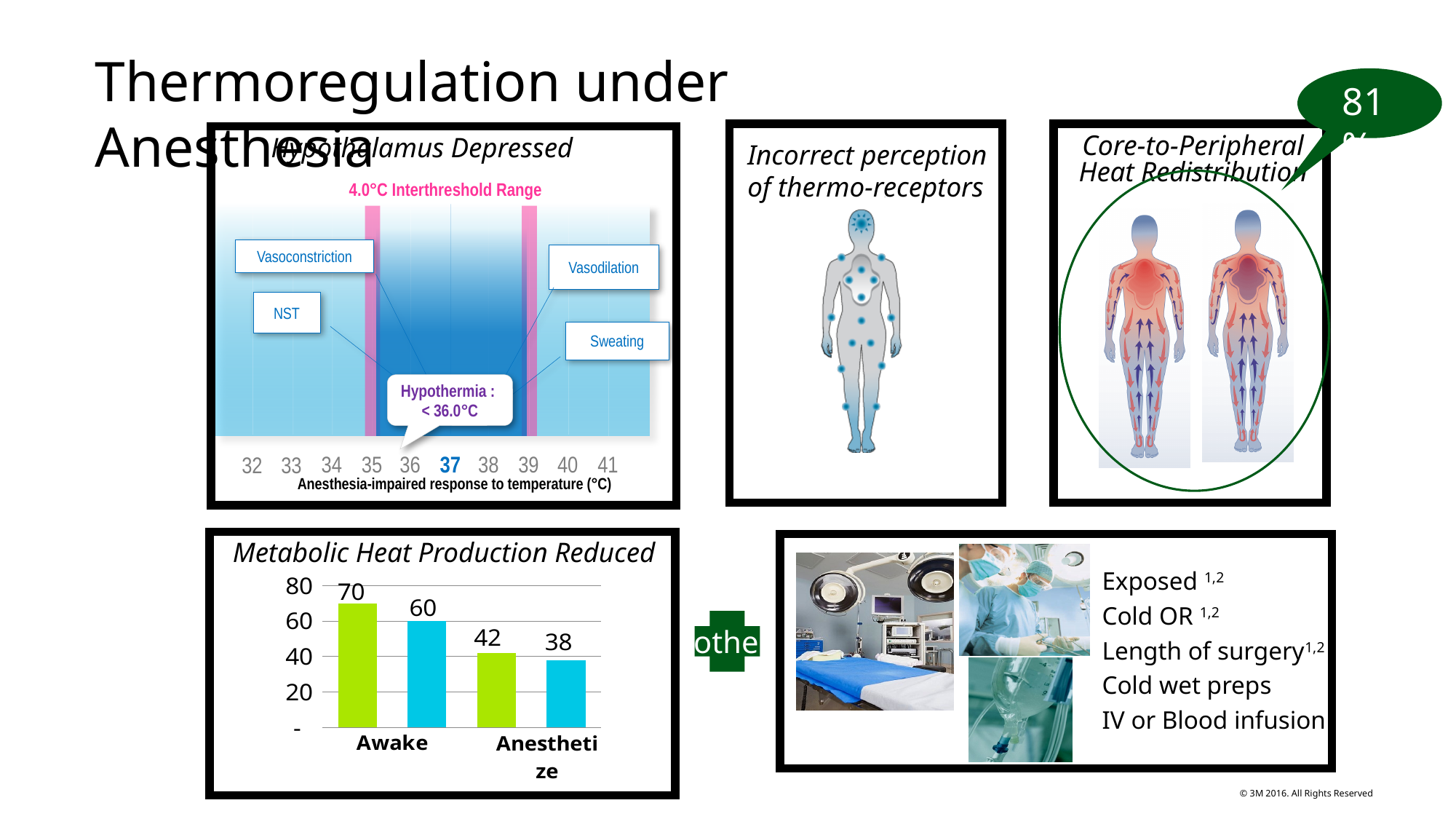
In the Metabolic Heat Production Reduced chart, is the green bar for Awake larger or smaller than the green bar for Anesthetize? larger In the Metabolic Heat Production Reduced chart, which bar has the highest value? Awake (green bar), 70 In the Metabolic Heat Production Reduced chart, how many categories are shown on the x axis? 2 In the Metabolic Heat Production Reduced chart, what is the value of the blue bar for Awake? 60 In the Metabolic Heat Production Reduced chart, what is the difference between the green bars for Awake and Anesthetize? 28 In the Metabolic Heat Production Reduced chart, what is the value of the green bar for Anesthetize? 42 In the Metabolic Heat Production Reduced chart, what is the difference between the blue bars for Awake and Anesthetize? 22 In the Metabolic Heat Production Reduced chart, do the values rise or fall from Awake to Anesthetize? fall In the Metabolic Heat Production Reduced chart, what is the value of the green bar for Awake? 70 In the Metabolic Heat Production Reduced chart, what is the value of the blue bar for Anesthetize? 38 In the Metabolic Heat Production Reduced chart, which bar has the lowest value? Anesthetize (blue bar), 38 What type of chart is the Metabolic Heat Production Reduced chart? bar chart